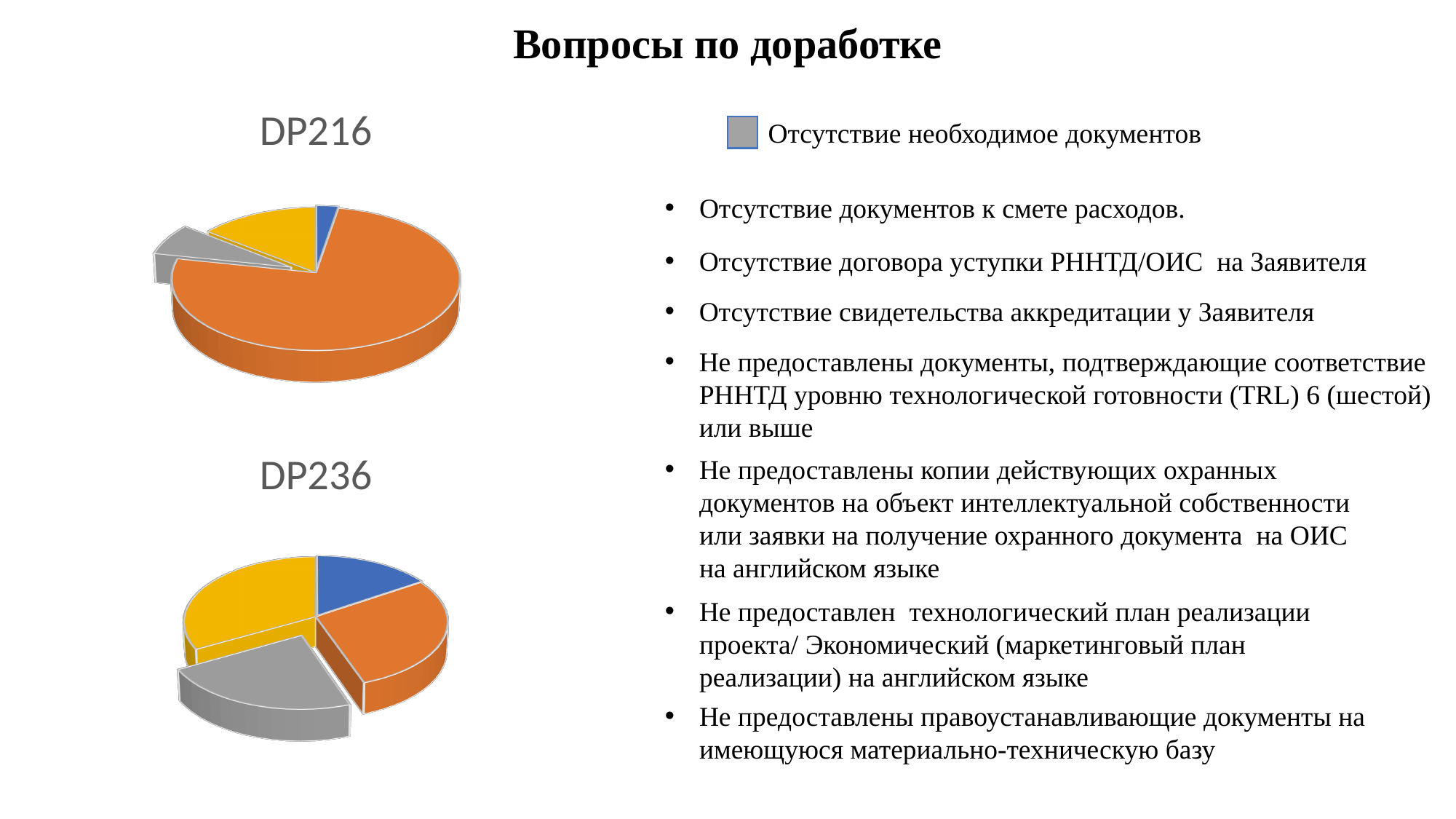
What kind of chart is the DP236 chart? pie chart In the DP236 chart, which is larger, the grey slice or the blue slice? grey How many slices does the DP216 pie chart have? 4 What colour is shown in the legend next to "Отсутствие необходимое документов"? grey In the DP236 chart, which is larger, the orange slice or the blue slice? orange How many slices does the DP236 pie chart have? 4 What kind of chart is the DP216 chart? pie chart In the DP216 chart, which colour slice is the largest? orange In the DP236 chart, which colour slice is the smallest? blue In the DP216 chart, which colour slice is the smallest? blue In the DP216 chart, which is larger, the orange slice or the yellow slice? orange What is the title of the top pie chart on the slide? DP216